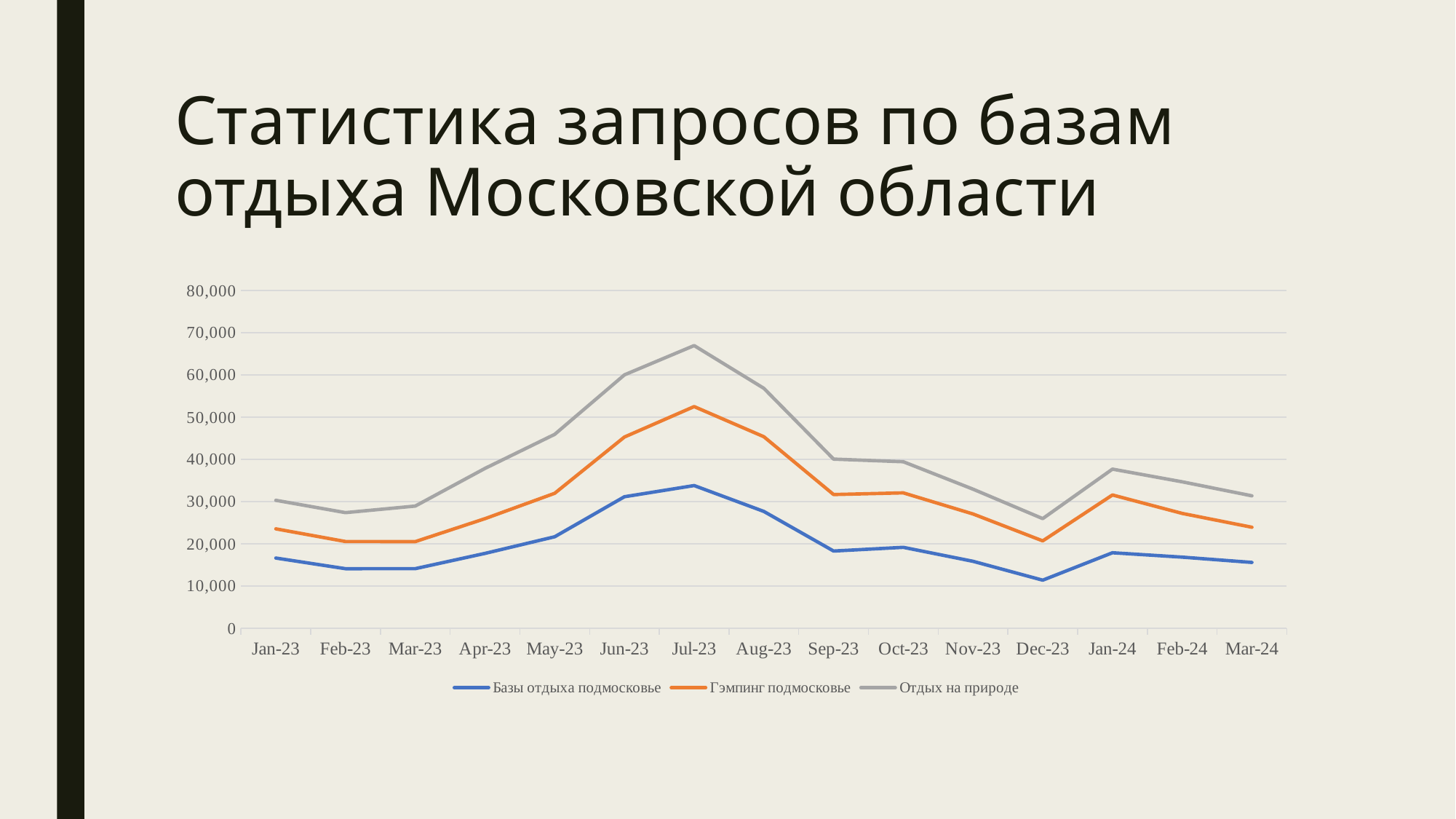
In which month does the series "Базы отдыха подмосковье" reach its lowest value? Dec-23 Does the series "Базы отдыха подмосковье" rise or fall from Jul-23 to Dec-23? Fall In which month does the series "Гэмпинг подмосковье" reach its highest value? Jul-23 How many months are plotted along the x axis? 15 What kind of chart is shown on the slide? Line chart Is the value for "Базы отдыха подмосковье" in Dec-23 greater or less than 20,000? less Which is larger for "Отдых на природе": the value in Jun-23 or the value in Jan-24? Jun-23 How many series does the legend list? 3 What is the title of the chart slide? Статистика запросов по базам отдыха Московской области